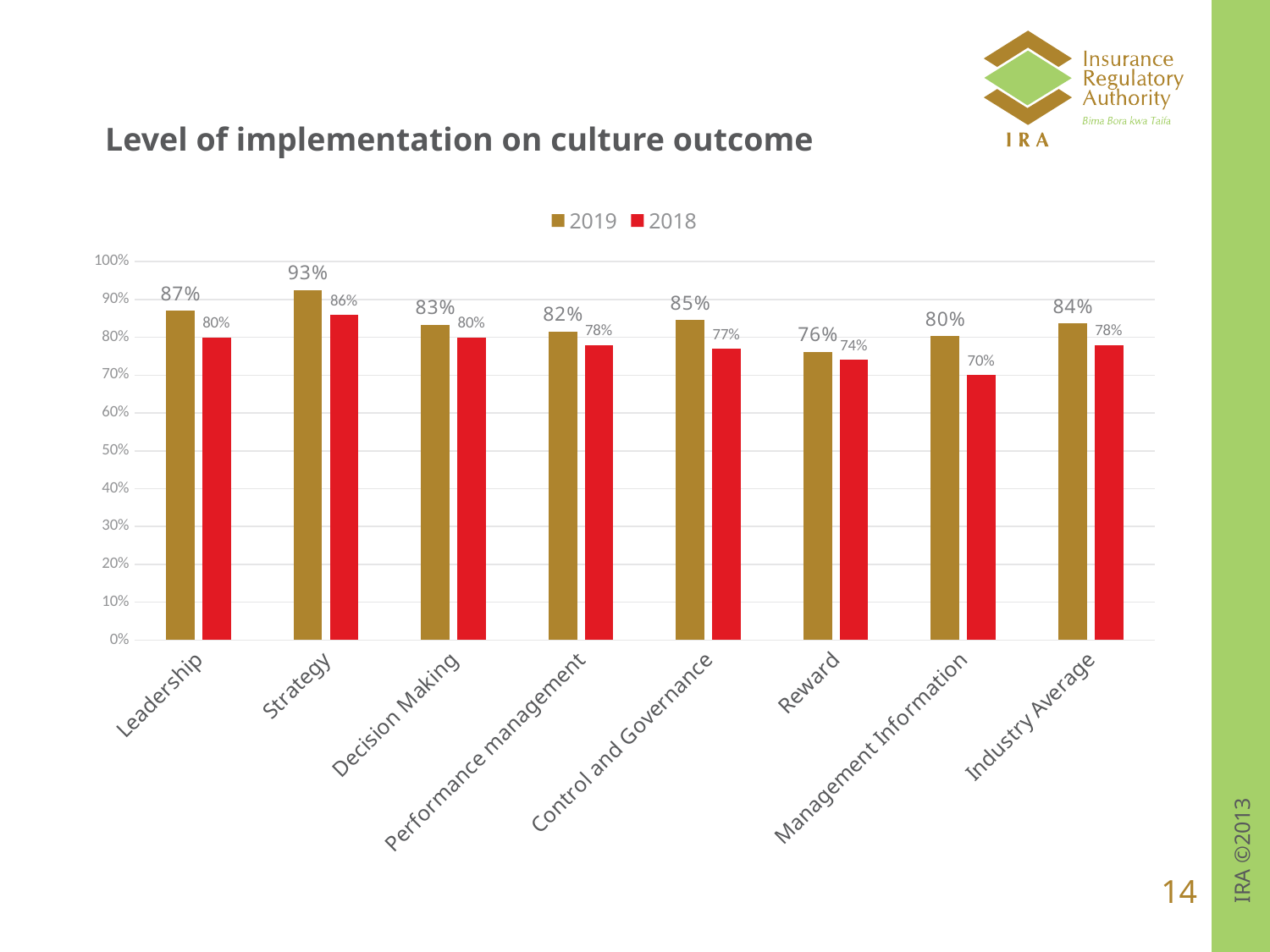
What is the 2018 value for Management Information? 70% What is the 2019 value for Strategy? 93% Is the 2018 value for Reward greater or less than 80%? less Which category has the lowest 2018 value? Management Information Which category has the highest 2019 value? Strategy How many categories are shown on the x axis? 8 What is the title of the slide? Level of implementation on culture outcome Which is larger: the 2019 value for Leadership or the 2019 value for Control and Governance? Leadership What is the difference between the 2019 and 2018 values for Management Information? 10% How many series does the legend list? 2 What is the 2019 value for Industry Average? 84% What kind of chart is shown on the slide? bar chart